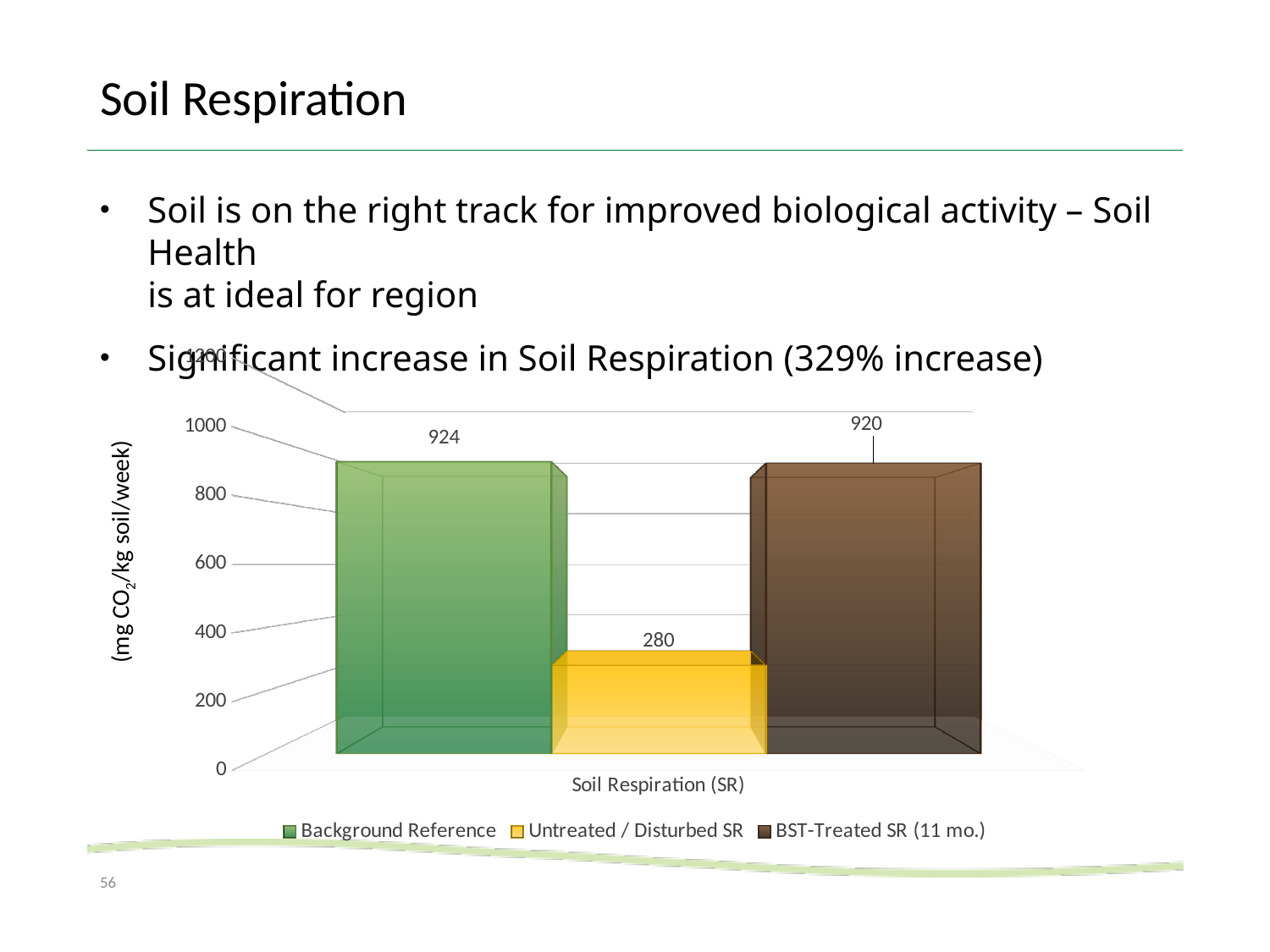
What is the difference between the Background Reference value and the Untreated / Disturbed SR value? 644 Which is larger, the value for Untreated / Disturbed SR or the value for BST-Treated SR (11 mo.)? BST-Treated SR (11 mo.) Is the value for Untreated / Disturbed SR greater or less than 400? less What is the x-axis label of the chart? Soil Respiration (SR) What is the value for Background Reference? 924 What colour is the bar for Untreated / Disturbed SR? yellow Which series has the lowest value? Untreated / Disturbed SR What is the value for BST-Treated SR (11 mo.)? 920 What kind of chart is shown on the slide? bar chart How many series does the legend list? 3 What is the difference between the BST-Treated SR (11 mo.) value and the Untreated / Disturbed SR value? 640 What is the value for Untreated / Disturbed SR? 280